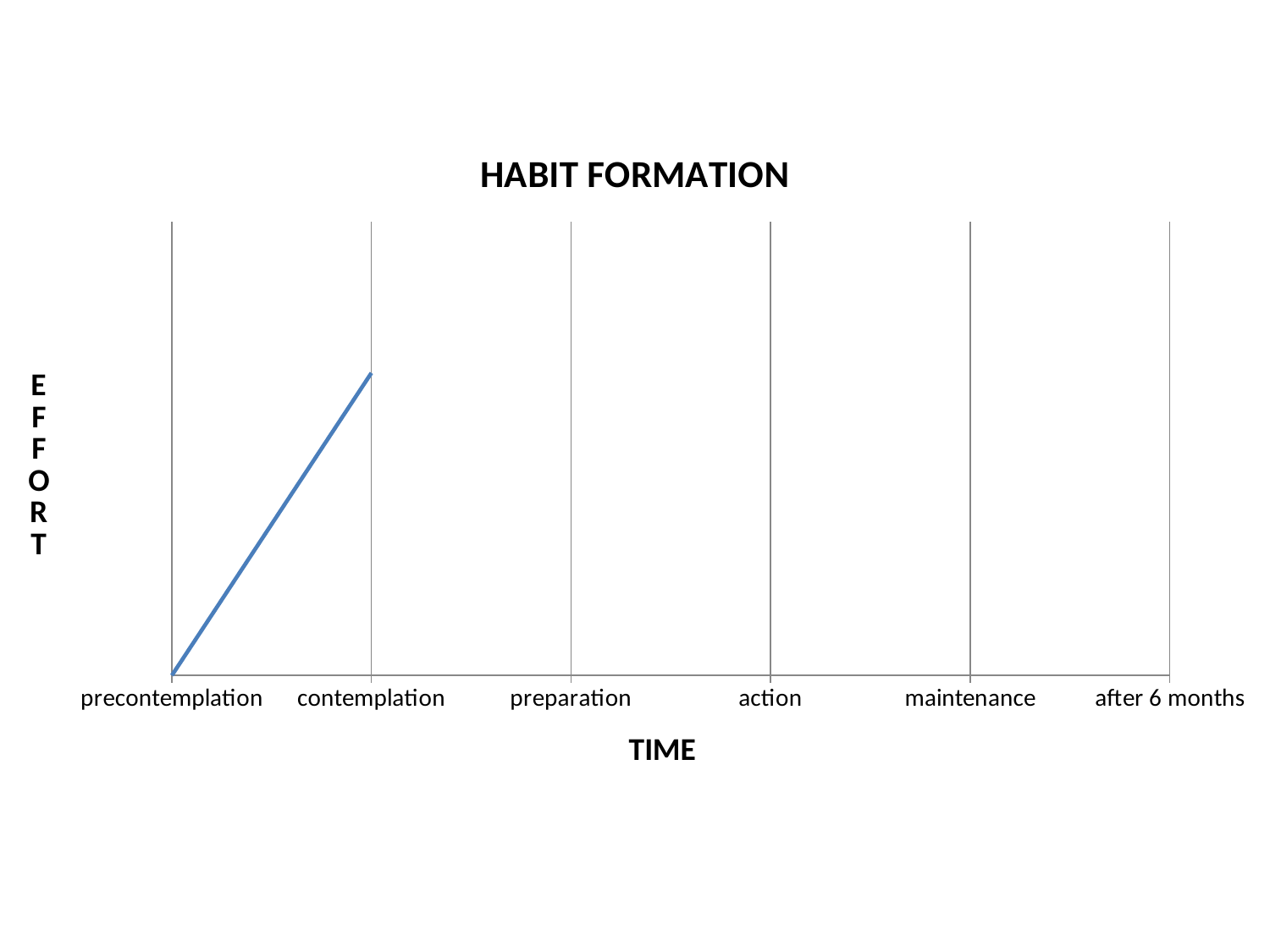
Which category has the highest plotted value on the line? contemplation What label is shown on the vertical axis of the chart? EFFORT How many categories are shown along the x axis of the chart? 6 Between which two x-axis categories is the line plotted? precontemplation and contemplation What kind of chart is shown on the slide? line chart Does the plotted line rise or fall from precontemplation to contemplation? rise How many lines are plotted on the chart? 1 Which category has the lowest plotted value on the line? precontemplation What is the title of the chart? HABIT FORMATION Which has the higher plotted value, precontemplation or contemplation? contemplation